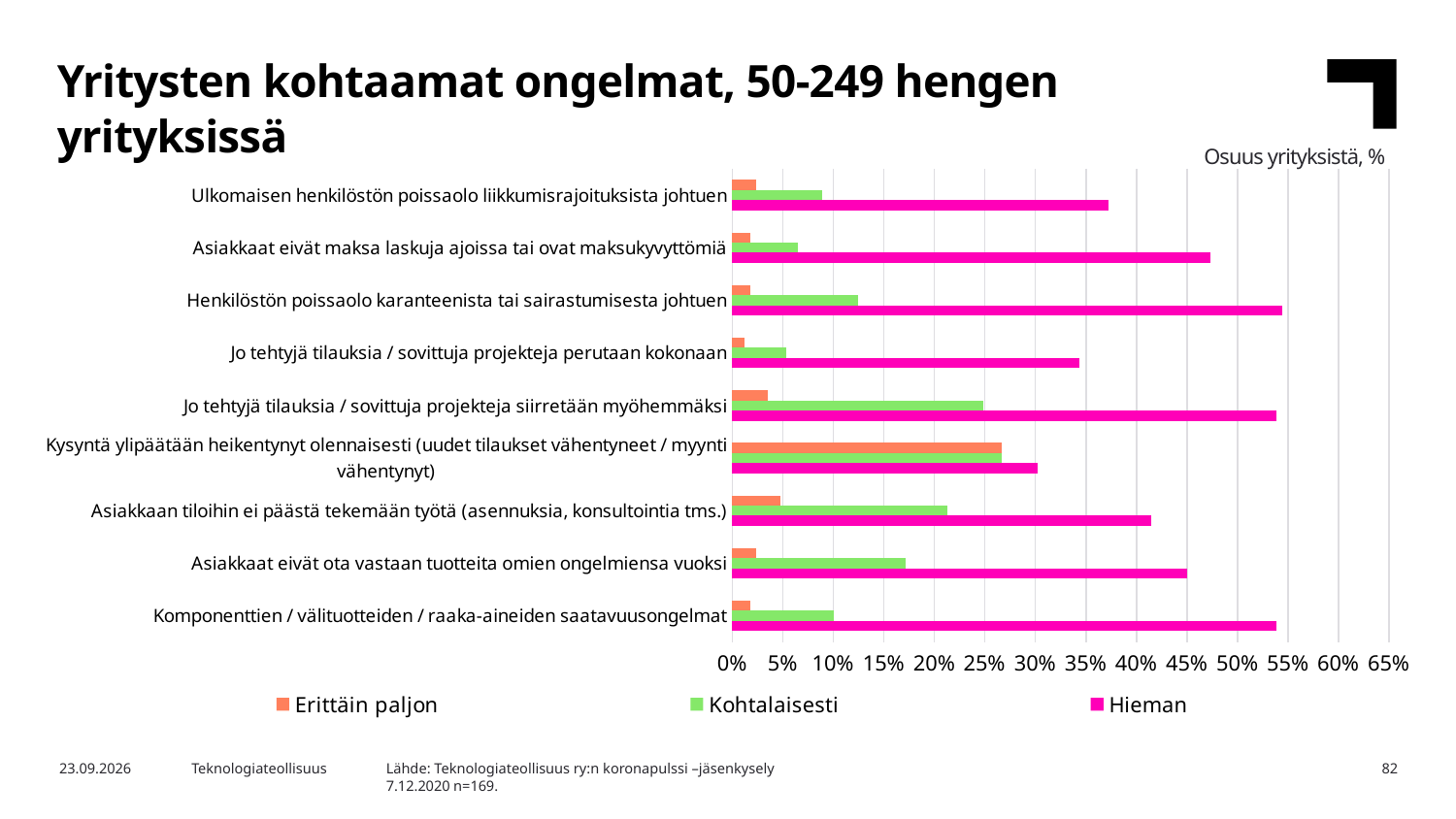
Which series is shown in magenta in the legend? Hieman For the series 'Kohtalaisesti', which is larger: 'Asiakkaan tiloihin ei päästä tekemään työtä' or 'Komponenttien / välituotteiden / raaka-aineiden saatavuusongelmat'? Asiakkaan tiloihin ei päästä tekemään työtä Which category has the highest value for the series 'Erittäin paljon'? Kysyntä ylipäätään heikentynyt olennaisesti (uudet tilaukset vähentyneet / myynti vähentynyt) How many categories (problems) are plotted on the chart? 9 Is the 'Kohtalaisesti' value for 'Jo tehtyjä tilauksia / sovittuja projekteja siirretään myöhemmäksi' greater or less than 20%? greater Which category has the lowest value for the series 'Hieman'? Kysyntä ylipäätään heikentynyt olennaisesti (uudet tilaukset vähentyneet / myynti vähentynyt) Is the 'Hieman' value for 'Asiakkaat eivät maksa laskuja ajoissa tai ovat maksukyvyttömiä' greater or less than 45%? greater What kind of chart is shown on the slide? Bar chart How many series does the legend list? 3 Is the 'Erittäin paljon' value for 'Kysyntä ylipäätään heikentynyt olennaisesti' greater or less than 25%? greater For the series 'Hieman', which is larger: 'Asiakkaat eivät ota vastaan tuotteita omien ongelmiensa vuoksi' or 'Asiakkaan tiloihin ei päästä tekemään työtä'? Asiakkaat eivät ota vastaan tuotteita omien ongelmiensa vuoksi